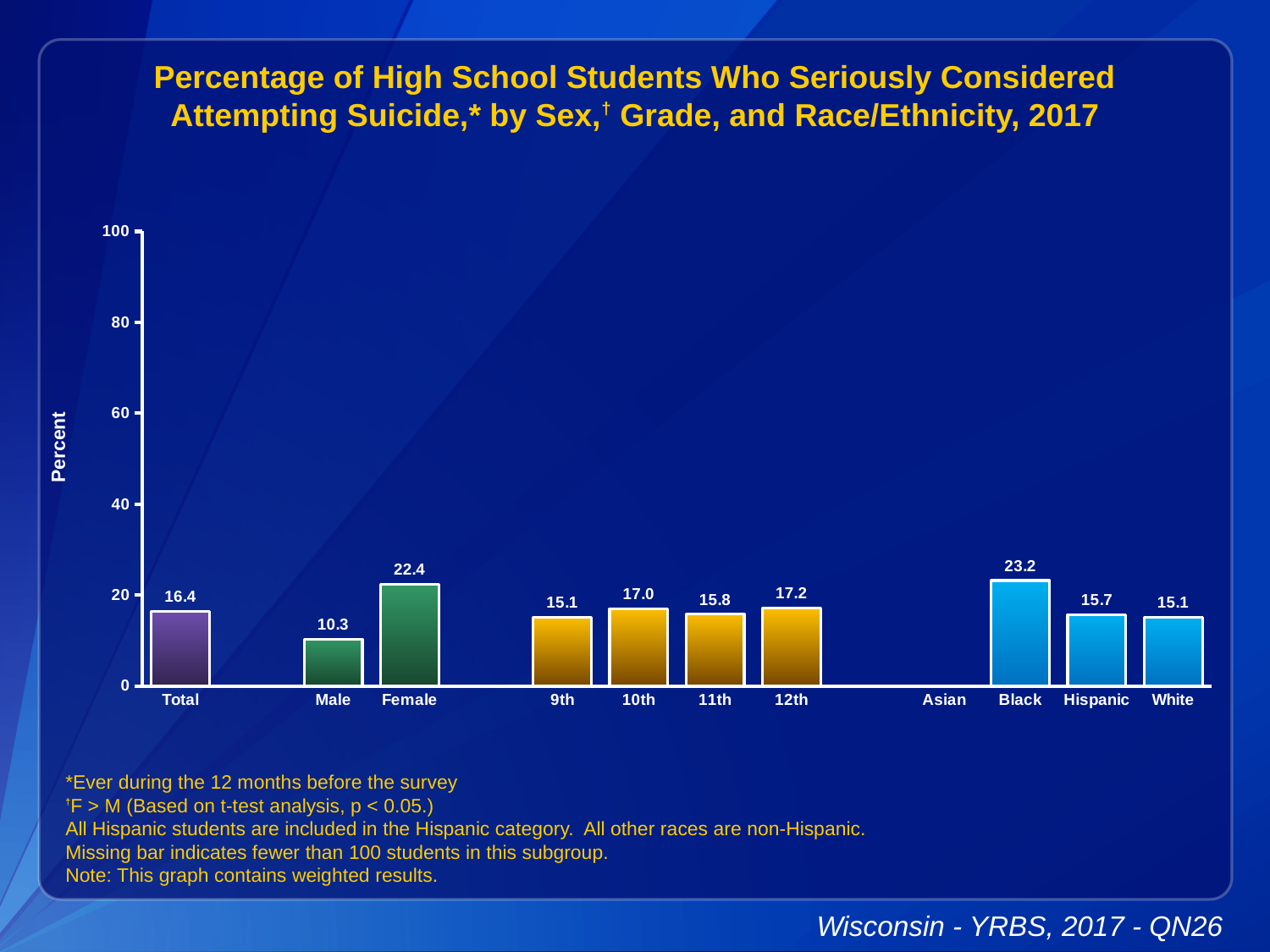
What is the value for Female? 22.4 Which category has the highest value? Black How many categories have a bar plotted? 11 What is the value for Male? 10.3 What is the value for Black? 23.2 What is the value for Total? 16.4 What kind of chart is this? Bar chart Which category has no bar shown? Asian Which is larger, the value for 10th or the value for 11th? 10th Is the value for Female greater or less than 20? greater Which category has the lowest value? Male What is the difference between the Female and Male values? 12.1